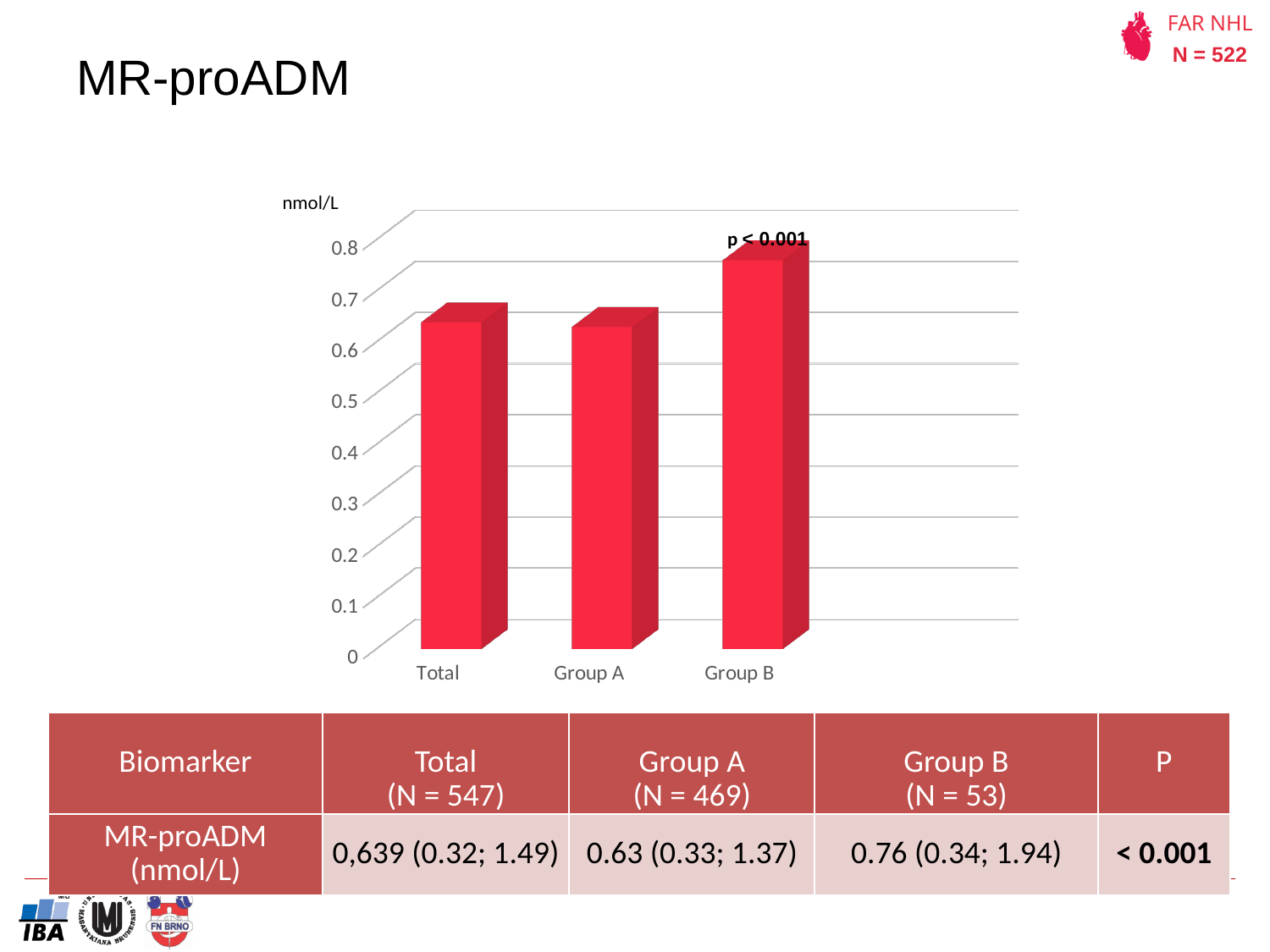
What kind of chart is shown on the slide? bar chart Is the value for Total greater or less than 0.5? greater What unit is shown on the y axis of the chart? nmol/L Is the value for Group B greater or less than 0.7? greater Is the value for Group A greater or less than 0.5? greater What annotation is printed above the Group B bar in the chart? p < 0.001 Which is larger in the chart, the value for Group B or the value for Group A? Group B Which is larger in the chart, the value for Total or the value for Group B? Group B How many categories are plotted on the x axis of the chart? 3 Which category has the highest bar in the chart? Group B